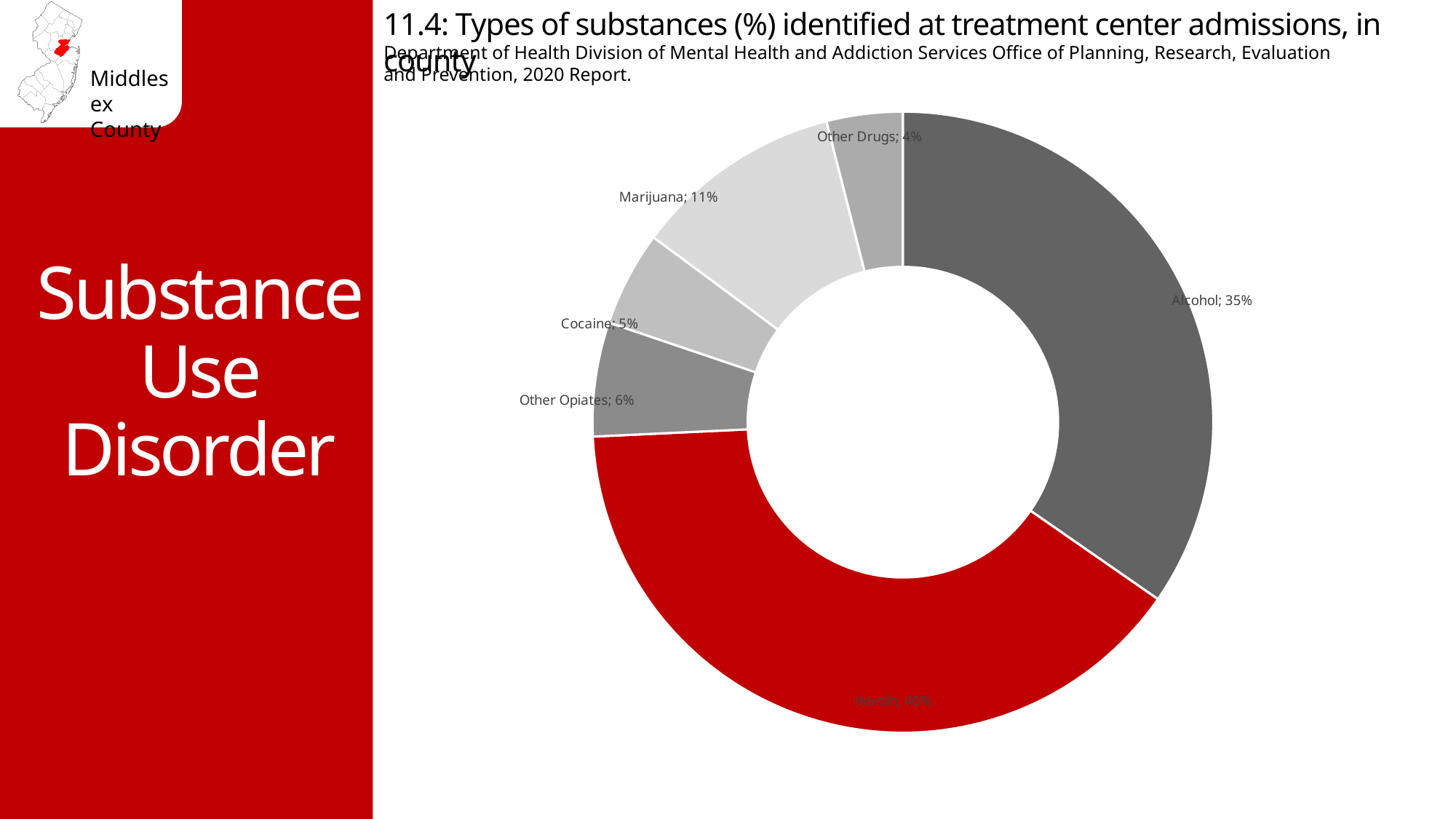
What percentage is shown for Marijuana? 11% Which substance has the largest share of treatment center admissions? Heroin Which substance has the smallest share of treatment center admissions? Other Drugs Which has a larger share, Marijuana or Cocaine? Marijuana What percentage of treatment center admissions is attributed to Heroin? 40% What percentage is shown for Cocaine? 5% What percentage of treatment center admissions is attributed to Alcohol? 35% What percentage is shown for Other Opiates? 6% What is the difference in percentage points between Heroin and Alcohol? 5 What type of chart is used on this slide? Doughnut (pie) chart How many substance categories are shown in the chart? 6 Which substance's slice is coloured red? Heroin